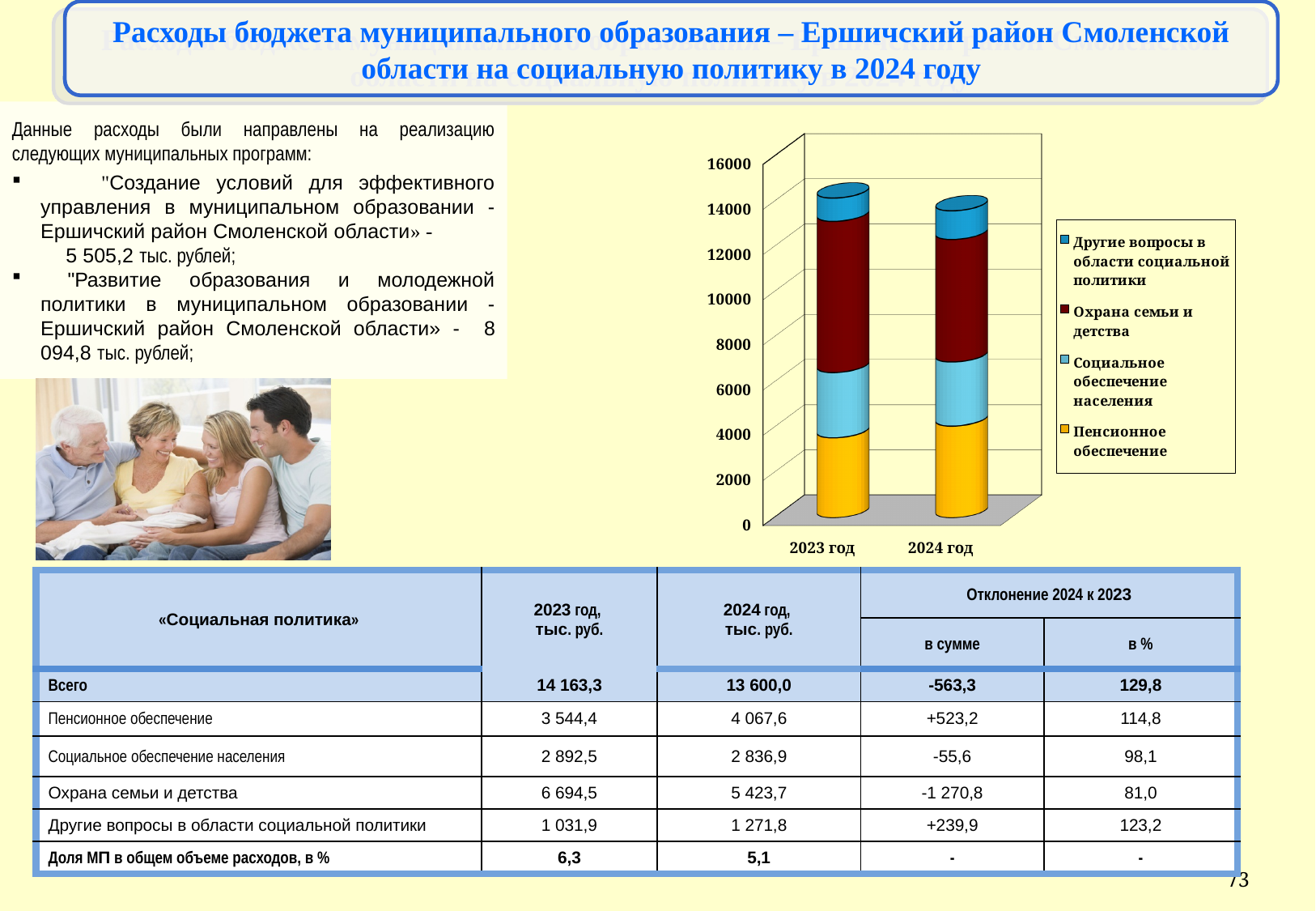
What kind of chart is shown on the slide? stacked bar chart How many categories (years) are plotted on the x axis of the chart? 2 Is the Пенсионное обеспечение segment of the 2023 год bar greater or less than 4000? less Is the total height of the 2023 год bar greater or less than 16000? less How many series does the chart legend list? 4 Which series is drawn in dark red in the chart? Охрана семьи и детства Is the total height of the 2024 год bar greater or less than 14000? less Which year has the taller stacked bar in the chart, 2023 год or 2024 год? 2023 год What is the highest value shown on the chart's vertical axis? 16000 Do the total bar heights rise or fall from 2023 год to 2024 год? fall Which series is shown at the bottom of each stacked bar? Пенсионное обеспечение